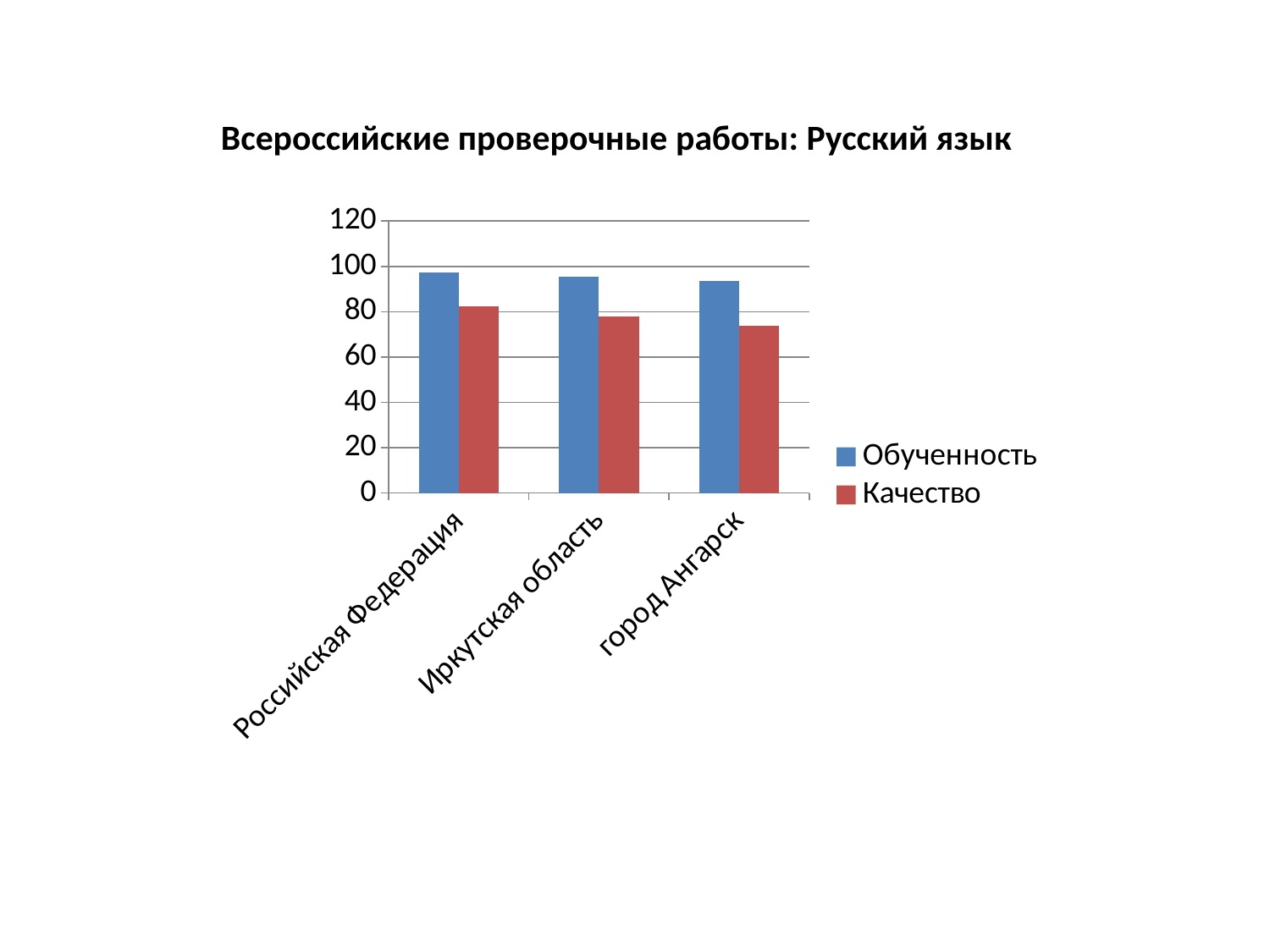
Which category has the lowest value for Качество? город Ангарск Which series is shown in red? Качество Is the value for Обученность in Российская Федерация greater or less than 80? greater Is the value for Обученность in город Ангарск greater or less than 100? less Which category has the highest value for Качество? Российская Федерация How many series does the legend list? 2 What kind of chart is shown on the slide? bar chart What is the title of the chart? Всероссийские проверочные работы: Русский язык Do the Качество values rise or fall from Российская Федерация to город Ангарск? fall Is the value for Качество in город Ангарск greater or less than 80? less How many categories are shown on the x axis? 3 For Иркутская область, which is larger: Обученность or Качество? Обученность